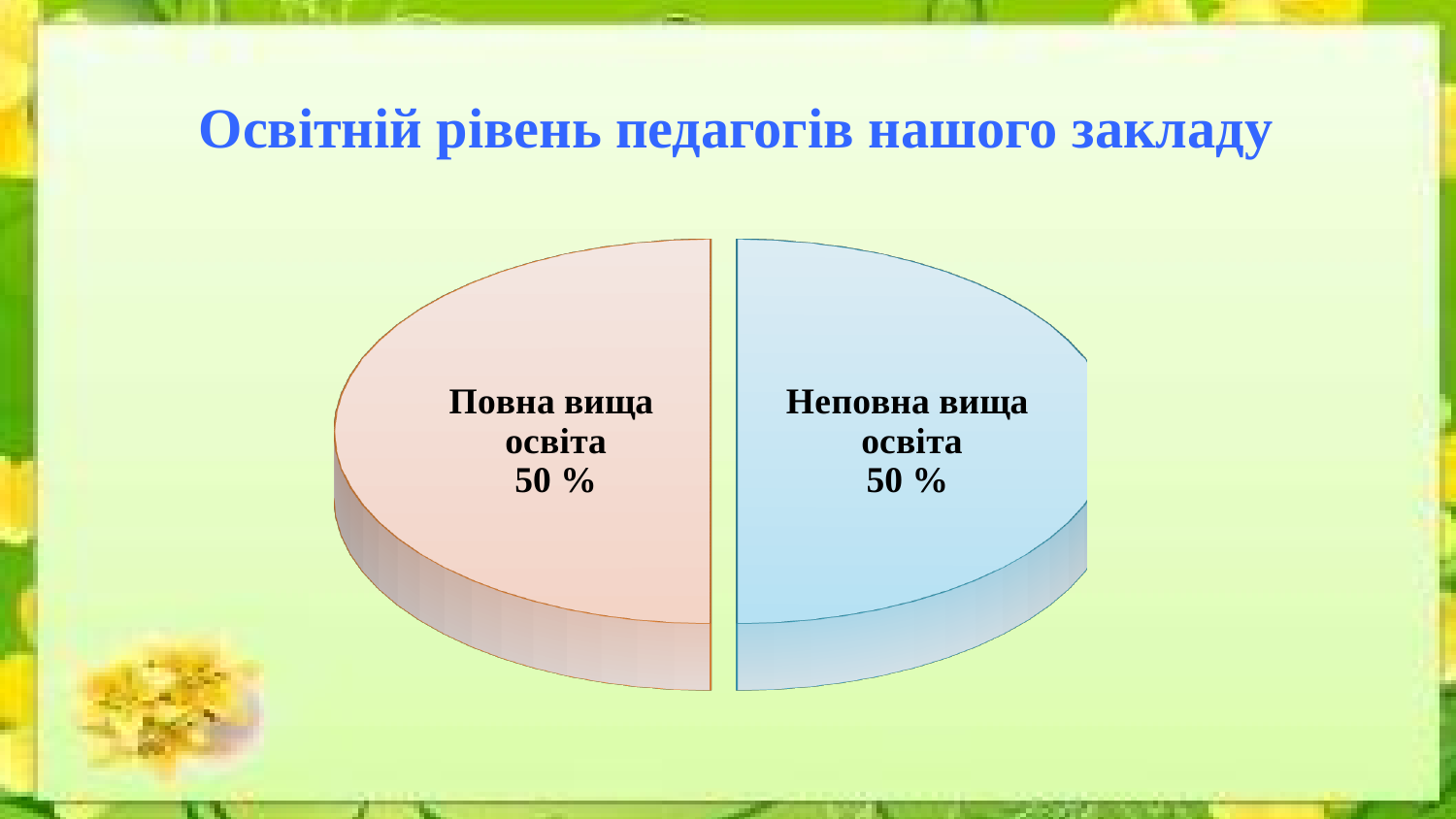
How many slices does the pie chart have? 2 What is the total of the two slices shown in the pie chart? 100 % What share of the pie does "Неповна вища освіта" represent? 50 % What share of the pie does "Повна вища освіта" represent? 50 % What colour is the "Неповна вища освіта" slice? Blue What is the difference between the values for "Повна вища освіта" and "Неповна вища освіта"? 0 % What is the title of the slide containing the chart? Освітній рівень педагогів нашого закладу What is the value shown for the "Повна вища освіта" slice? 50 % What kind of chart is shown on the slide? Pie chart What is the value shown for the "Неповна вища освіта" slice? 50 %